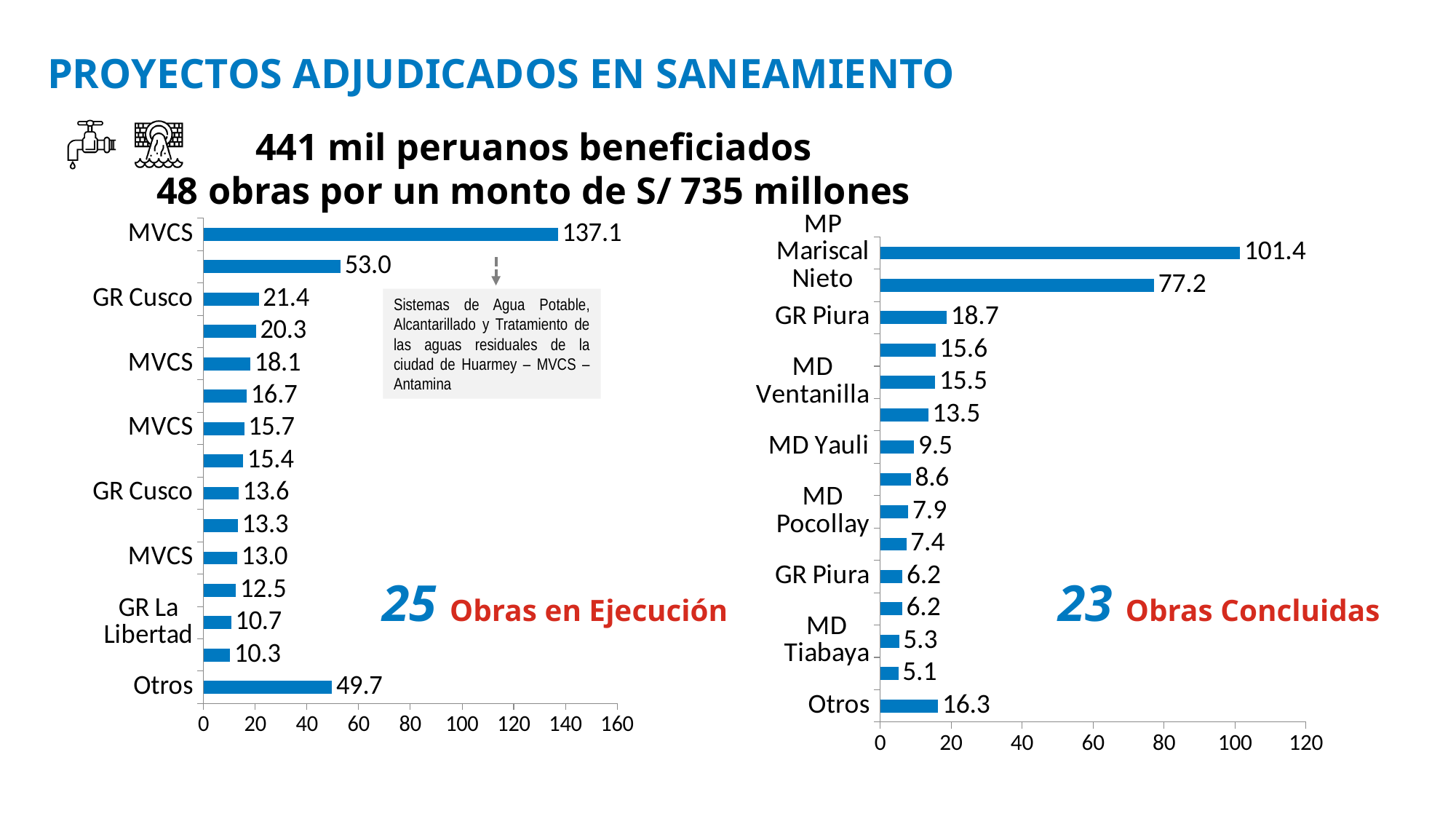
In the right chart (Obras Concluidas), what is the value for MD Pocollay? 7.9 In the right chart (Obras Concluidas), what is the highest value shown? 101.4 In the right chart (Obras Concluidas), what is the difference between the two largest bars, 101.4 and 77.2? 24.2 Which Otros value is larger: the one in the left chart (Obras en Ejecución) or the one in the right chart (Obras Concluidas)? Left chart (49.7) In the right chart (Obras Concluidas), what is the value for Otros? 16.3 In the right chart (Obras Concluidas), what is the smallest value shown? 5.1 How many bars are plotted in the right chart (Obras Concluidas)? 15 In the left chart (Obras en Ejecución), what is the difference between the two largest bars, 137.1 and 53.0? 84.1 In the right chart (Obras Concluidas), what is the value for MD Yauli? 9.5 In the left chart (Obras en Ejecución), what is the value of the longest bar, labelled MVCS at the top? 137.1 In the left chart (Obras en Ejecución), what is the value for Otros? 49.7 What type of chart is used on this slide? Bar chart